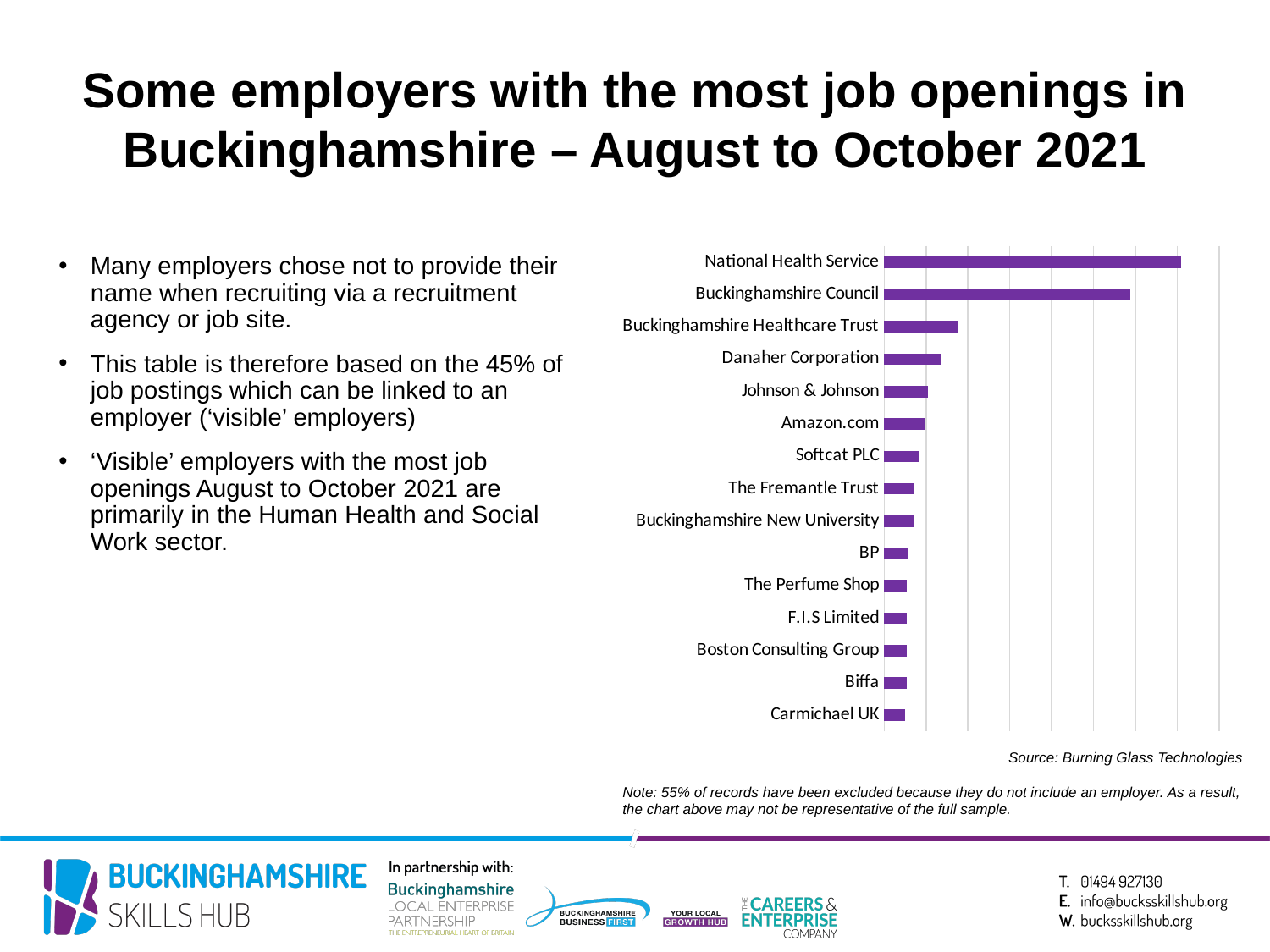
Which has more job openings, Johnson & Johnson or Softcat PLC? Johnson & Johnson What colour are the bars in the chart? purple Which has more job openings, National Health Service or Buckinghamshire Council? National Health Service Which employer has the highest number of job openings in the chart? National Health Service How many employers are listed in the chart? 15 What kind of chart is shown on the slide? bar chart Which has more job openings, Amazon.com or BP? Amazon.com Do the bar lengths increase or decrease going from the top of the chart to the bottom? decrease Which employer is listed at the bottom of the chart? Carmichael UK Are the bars in the chart horizontal or vertical? horizontal